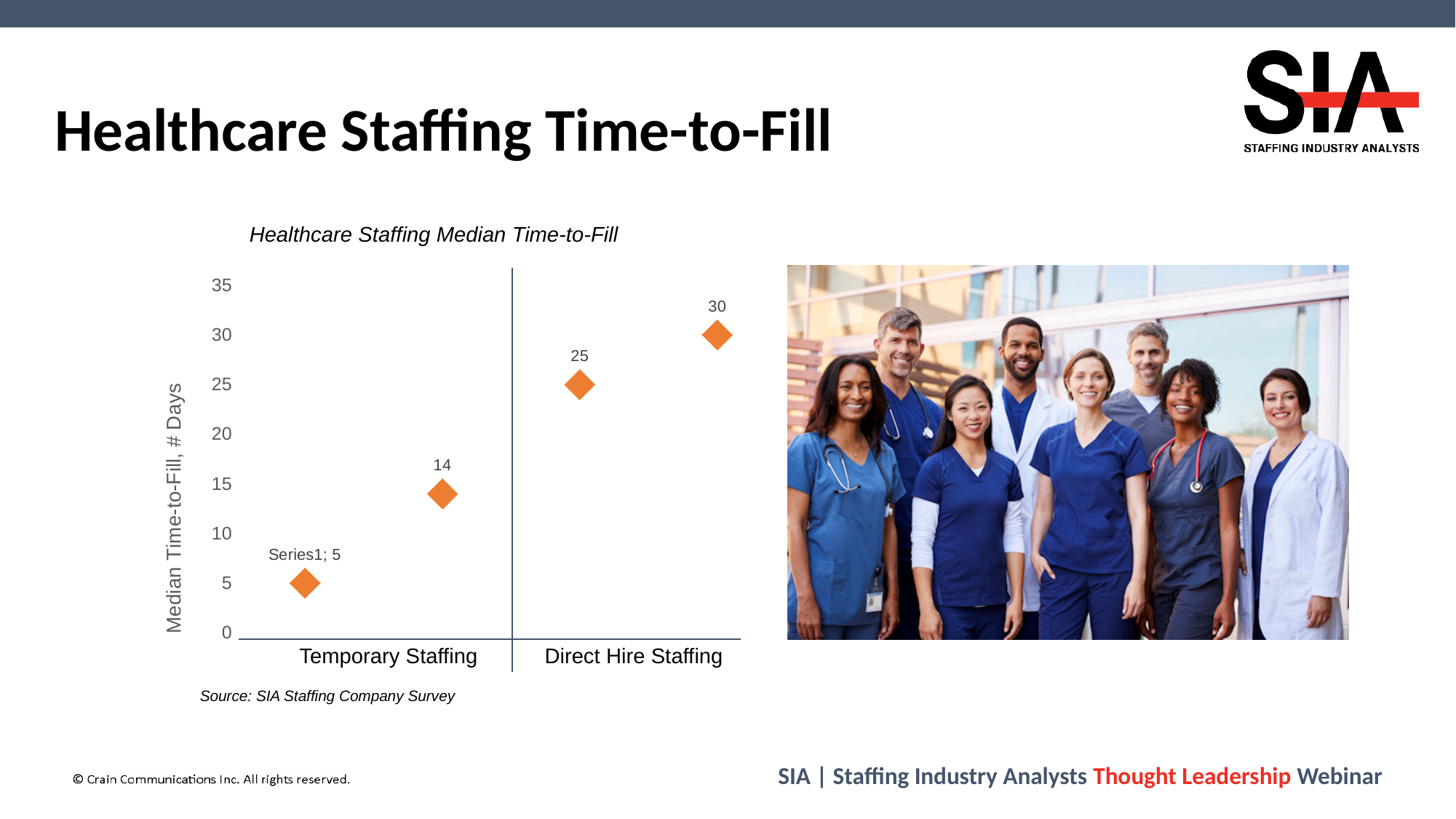
How many data points are plotted on the chart? 4 What is the title of the chart on the slide? Healthcare Staffing Median Time-to-Fill What is the difference between the highest Direct Hire Staffing value and the highest Temporary Staffing value? 16 What is the lowest value plotted on the chart? 5 What is the lowest value plotted for Temporary Staffing? 5 What is the highest value plotted for Direct Hire Staffing? 30 What is the lowest value plotted for Direct Hire Staffing? 25 How many categories are shown on the x-axis of the chart? 2 What is the highest value plotted on the chart? 30 Which category has the higher plotted values, Temporary Staffing or Direct Hire Staffing? Direct Hire Staffing What is the highest value plotted for Temporary Staffing? 14 What is the y-axis label of the chart? Median Time-to-Fill, # Days